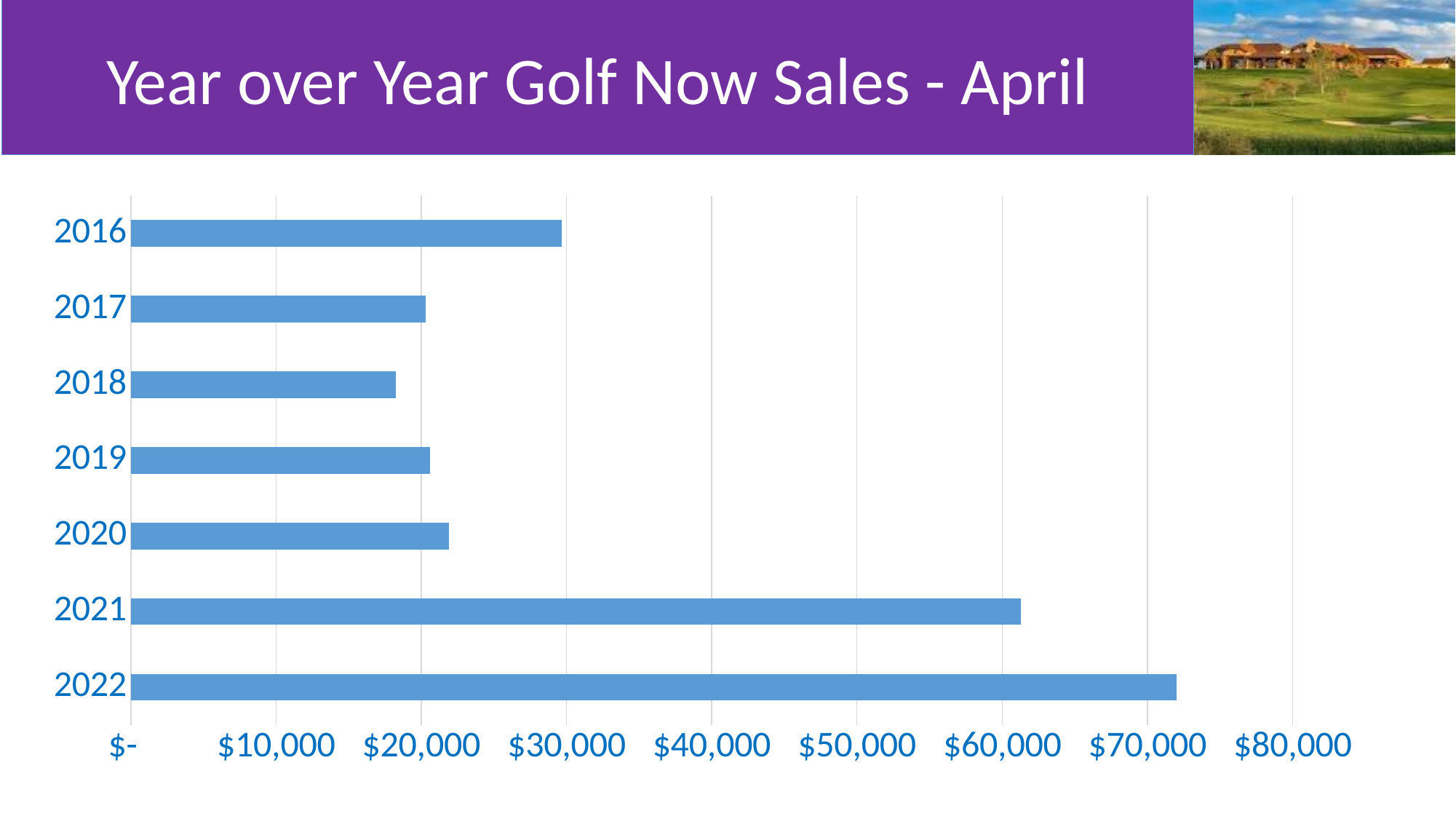
Is the value for 2022 greater or less than $70,000? greater What is the title of the chart? Year over Year Golf Now Sales - April How many years are shown on the chart? 7 What kind of chart is shown on the slide? Bar chart Is the value for 2021 greater or less than $50,000? greater Which year had higher sales, 2016 or 2017? 2016 Is the value for 2016 greater or less than $20,000? greater Which year has the highest Golf Now sales? 2022 Which year had higher sales, 2021 or 2022? 2022 Which year has the lowest Golf Now sales? 2018